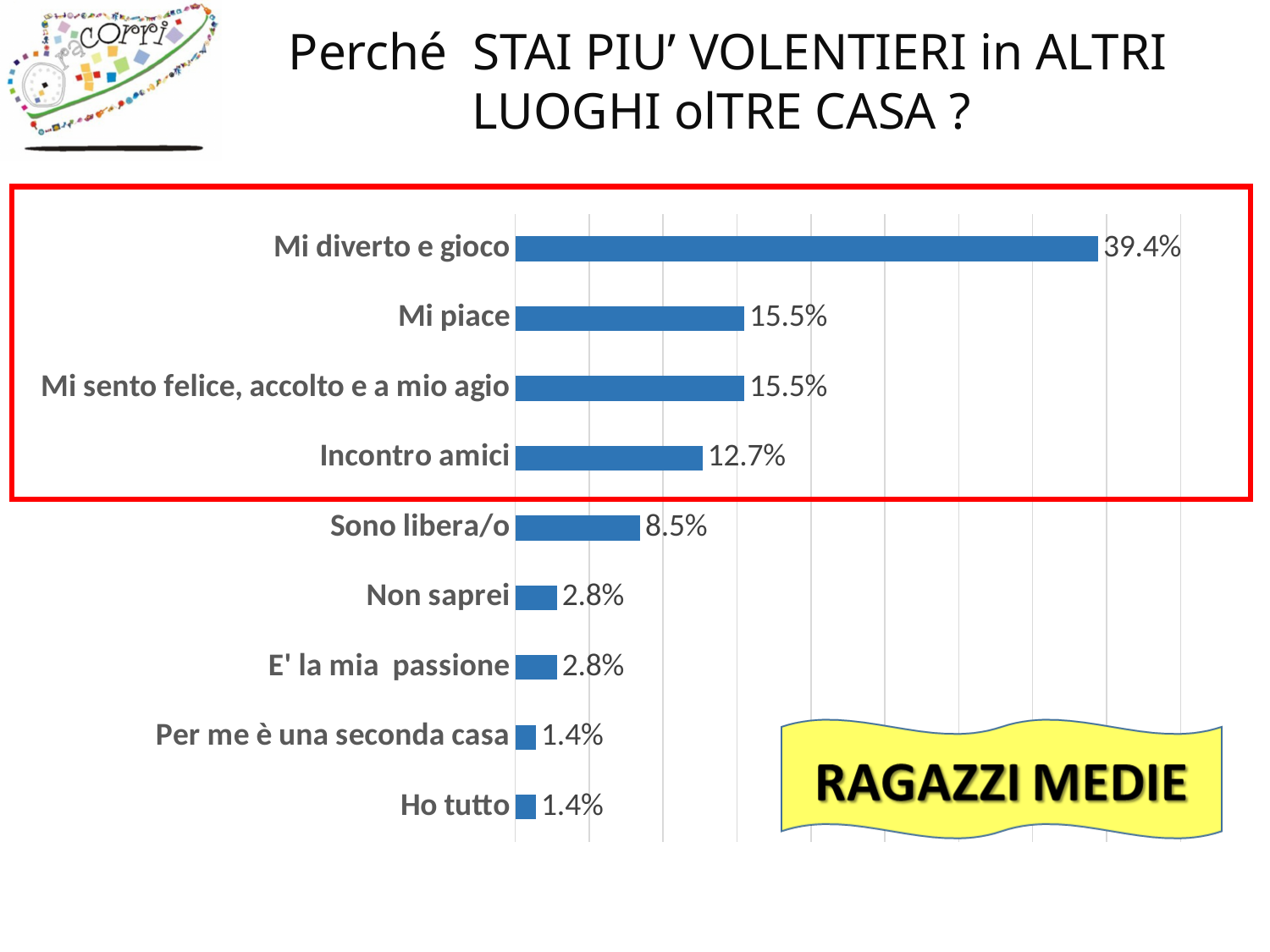
What value is shown for both "Mi piace" and "Mi sento felice, accolto e a mio agio"? 15.5% What kind of chart is shown on the slide? Bar chart How many categories are shown in the chart? 9 What is the value for "Sono libera/o"? 8.5% What is the value for "Incontro amici"? 12.7% What is the value for "Mi diverto e gioco"? 39.4% What is the value for "Per me è una seconda casa"? 1.4% Which is larger, the value for "Sono libera/o" or the value for "Non saprei"? Sono libera/o Which category has the highest value? Mi diverto e gioco What is the difference between the values for "Incontro amici" and "Sono libera/o"? 4.2% What text appears in the yellow label at the bottom right of the chart? RAGAZZI MEDIE What is the difference between the values for "Mi diverto e gioco" and "Mi piace"? 23.9%